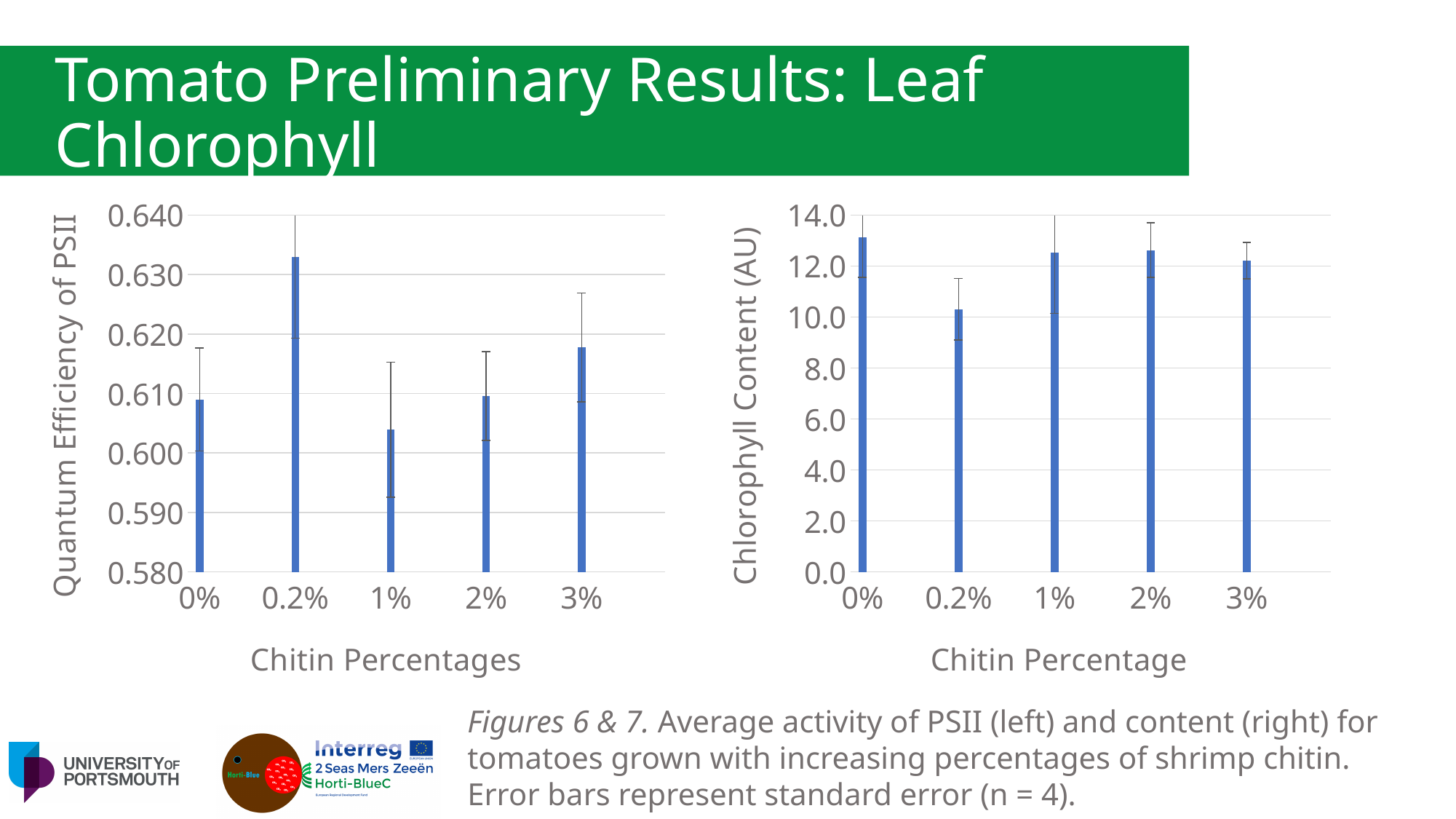
On the left chart (Quantum Efficiency of PSII), is the value for 0.2% greater or less than 0.630? greater What is the y-axis title of the right chart? Chlorophyll Content (AU) On the left chart (Quantum Efficiency of PSII), is the value for 1% greater or less than 0.610? less On the left chart (Quantum Efficiency of PSII), which chitin percentage has the highest value? 0.2% On the left chart (Quantum Efficiency of PSII), which chitin percentage has the lowest value? 1% On the right chart (Chlorophyll Content), which is larger, the value for 0% or the value for 0.2%? 0% On the right chart (Chlorophyll Content), is the value for 0% greater or less than 12.0? greater What kind of chart is the left chart (Quantum Efficiency of PSII)? bar chart On the right chart (Chlorophyll Content), which chitin percentage has the highest value? 0% On the right chart (Chlorophyll Content), which chitin percentage has the lowest value? 0.2% How many chitin percentage categories are shown on the right chart (Chlorophyll Content)? 5